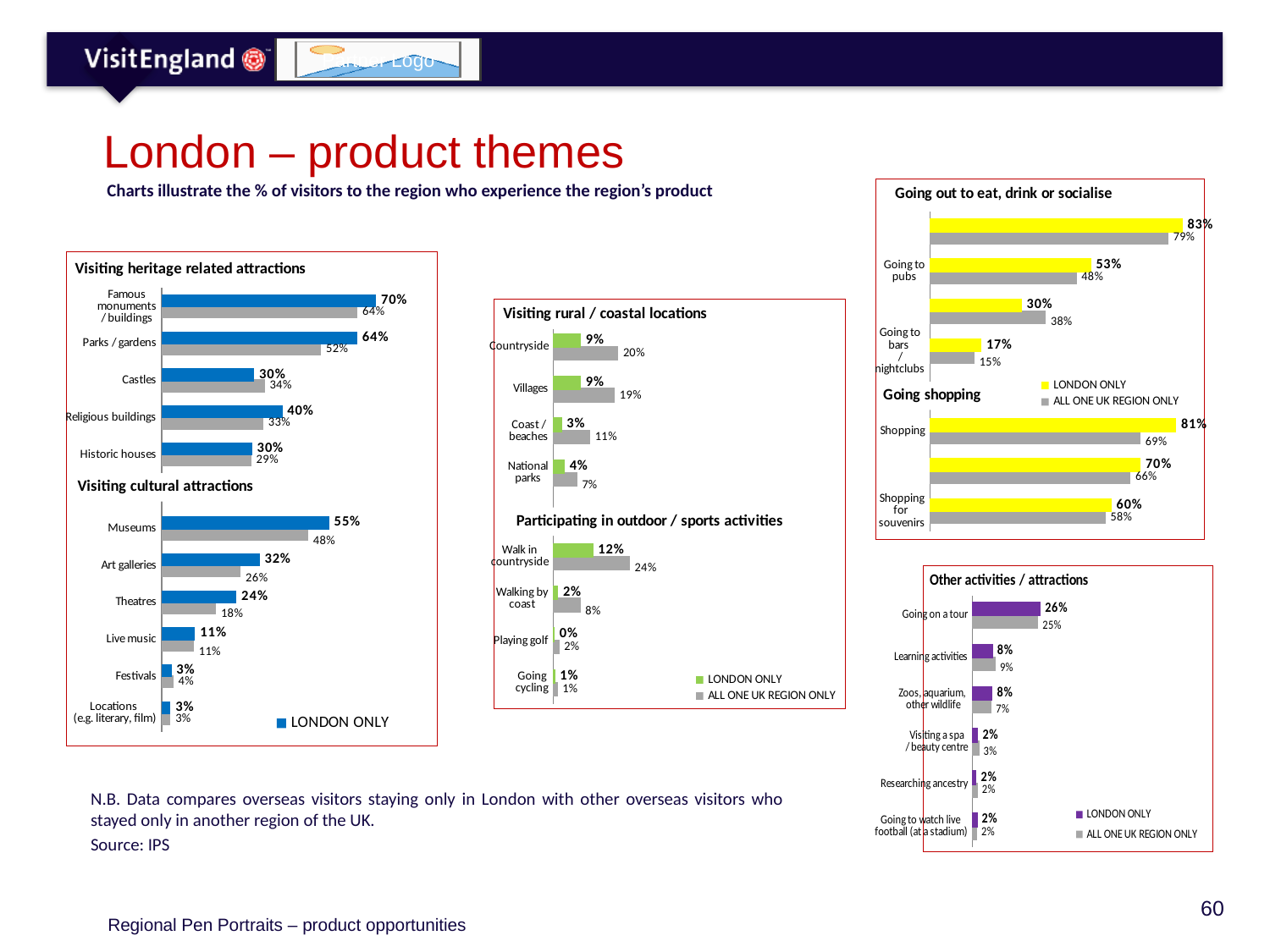
In the 'Visiting cultural attractions' chart, what is the difference between the LONDON ONLY and ALL ONE UK REGION ONLY values for Theatres? 6% In the 'Visiting heritage related attractions' chart, what is the ALL ONE UK REGION ONLY value for Parks / gardens? 52% What type of chart is the 'Other activities / attractions' chart? Bar chart In the 'Participating in outdoor / sports activities' chart, what is the LONDON ONLY value for Walk in countryside? 12% In the 'Visiting rural / coastal locations' chart, which is larger for Coast / beaches: the LONDON ONLY value or the ALL ONE UK REGION ONLY value? ALL ONE UK REGION ONLY In the 'Participating in outdoor / sports activities' chart, how many categories are shown? 4 In the 'Visiting rural / coastal locations' chart, what is the ALL ONE UK REGION ONLY value for Countryside? 20% In the 'Visiting heritage related attractions' chart, what is the LONDON ONLY value for Famous monuments / buildings? 70% In the 'Other activities / attractions' chart, which category has the highest LONDON ONLY value? Going on a tour In the 'Going out to eat, drink or socialise' chart, what is the LONDON ONLY value for Going to pubs? 53% In the 'Visiting cultural attractions' chart, which category has the highest LONDON ONLY value? Museums In the 'Going shopping' chart, what is the difference between the LONDON ONLY and ALL ONE UK REGION ONLY values for Shopping? 12%